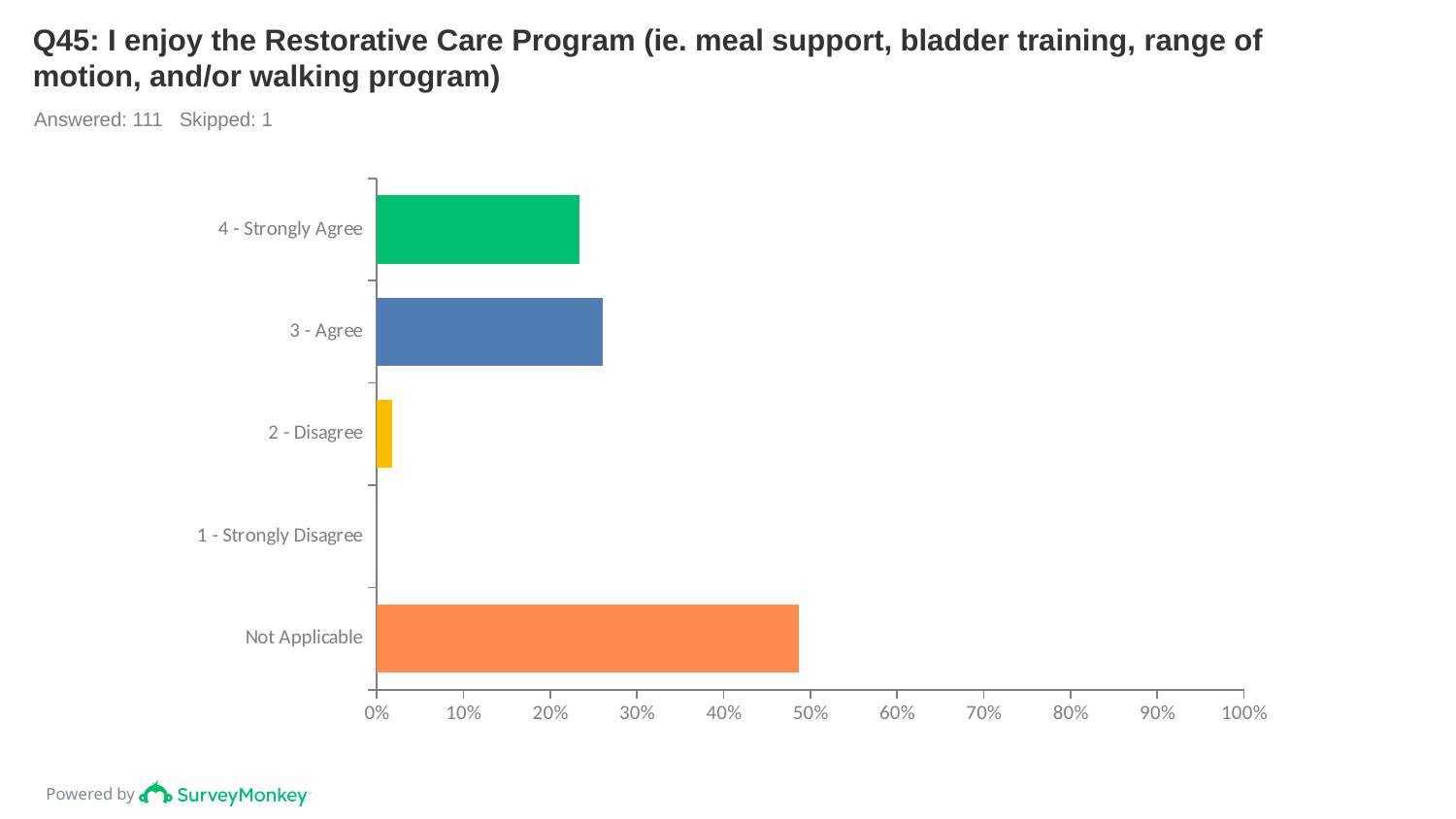
Is the value for Not Applicable greater or less than 40%? greater Which response category has the highest value? Not Applicable Is the value for 2 - Disagree greater or less than 10%? less How many response categories are shown on the chart? 5 Which is larger, the value for 3 - Agree or the value for 2 - Disagree? 3 - Agree How many respondents answered this question according to the slide? 111 Which response category has the lowest value? 1 - Strongly Disagree Which is larger, the value for Not Applicable or the value for 4 - Strongly Agree? Not Applicable Is the value for 3 - Agree greater or less than 30%? less What kind of chart is shown on the slide? bar chart What is the maximum value shown on the horizontal axis? 100%